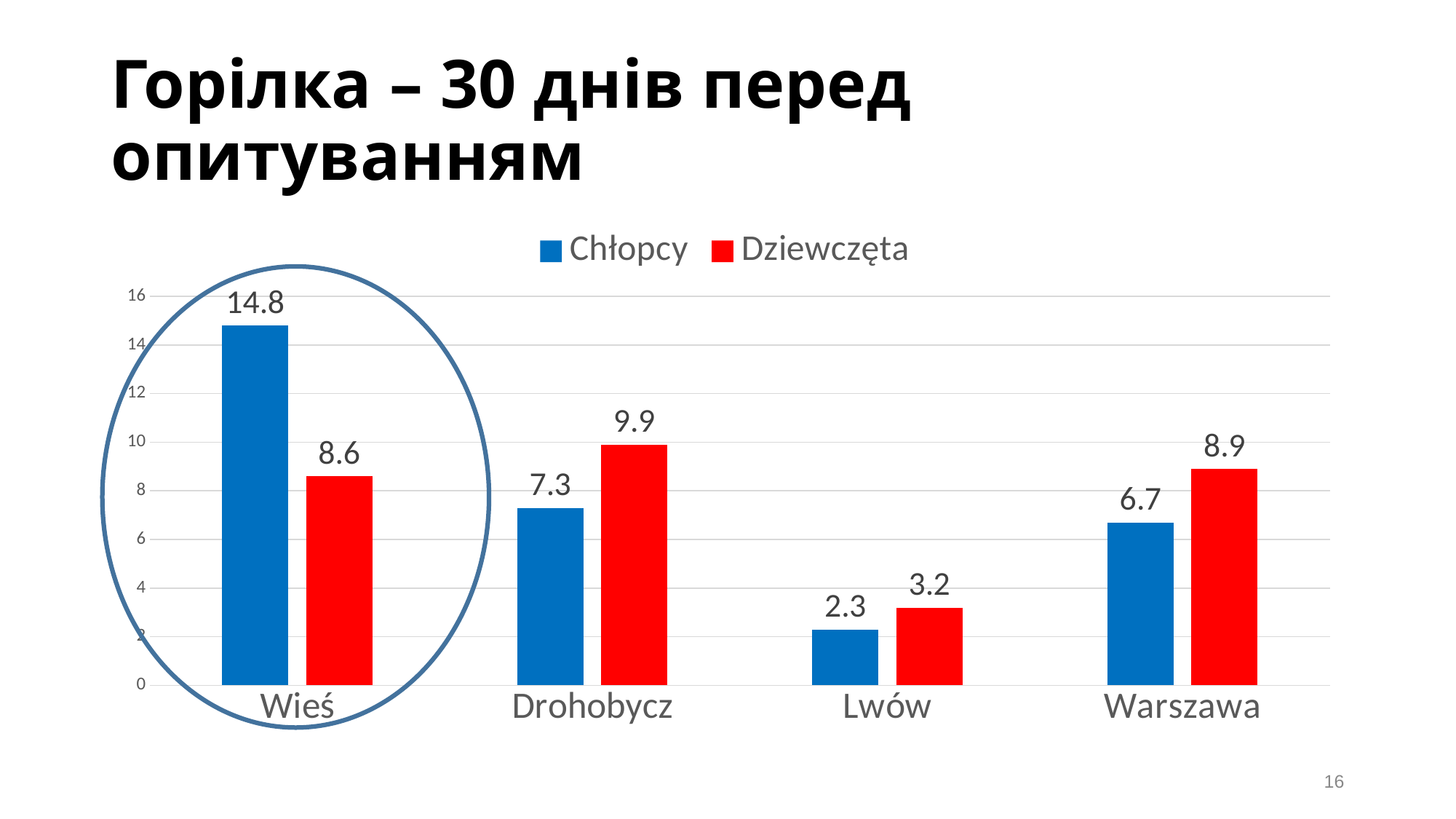
What is the value for Dziewczęta in Drohobycz? 9.9 Which is larger in Warszawa, the Chłopcy value or the Dziewczęta value? Dziewczęta What is the value for Dziewczęta in Warszawa? 8.9 How many series does the legend list? 2 What is the difference between the Chłopcy and Dziewczęta values in Wieś? 6.2 What is the value for Chłopcy in Wieś? 14.8 Which category has the highest value for Chłopcy? Wieś What is the value for Chłopcy in Lwów? 2.3 Which colour represents the Dziewczęta series? Red Which category has the lowest value for Dziewczęta? Lwów How many categories are shown on the x axis? 4 What kind of chart is shown on the slide? Bar chart